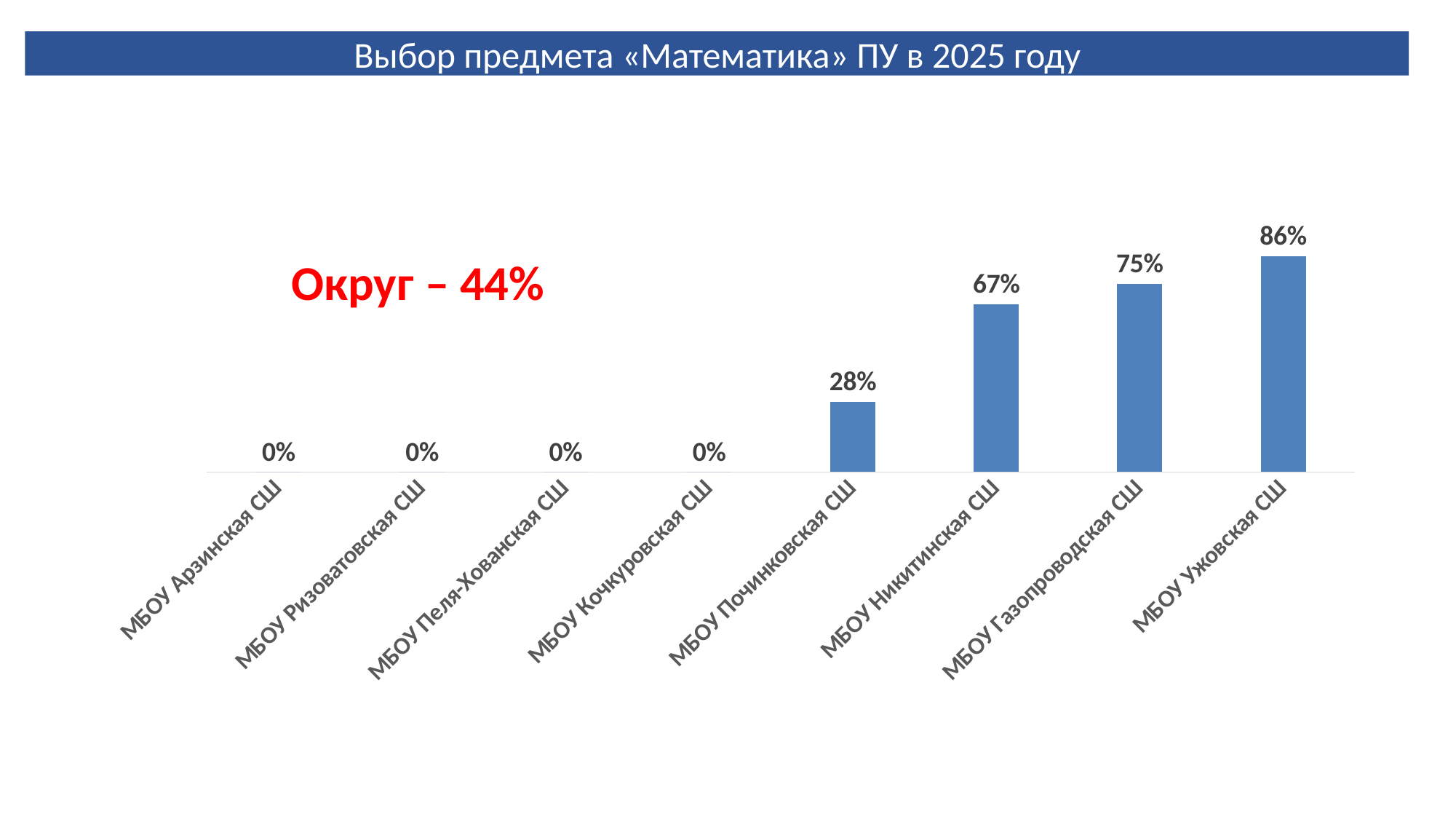
Which is larger, the value for МБОУ Никитинская СШ or МБОУ Починковская СШ? МБОУ Никитинская СШ What kind of chart is shown on the slide? bar chart What is the value for the district (Округ) shown in red text on the slide? 44% What is the difference between the values for МБОУ Газопроводская СШ and МБОУ Никитинская СШ? 8% What is the value for МБОУ Починковская СШ? 28% What is the value for МБОУ Ужовская СШ? 86% How many schools have a value of 0%? 4 What is the value for МБОУ Газопроводская СШ? 75% Which school has the highest value? МБОУ Ужовская СШ What is the difference between the values for МБОУ Ужовская СШ and МБОУ Починковская СШ? 58% What is the value for МБОУ Никитинская СШ? 67% How many schools are shown on the x axis? 8